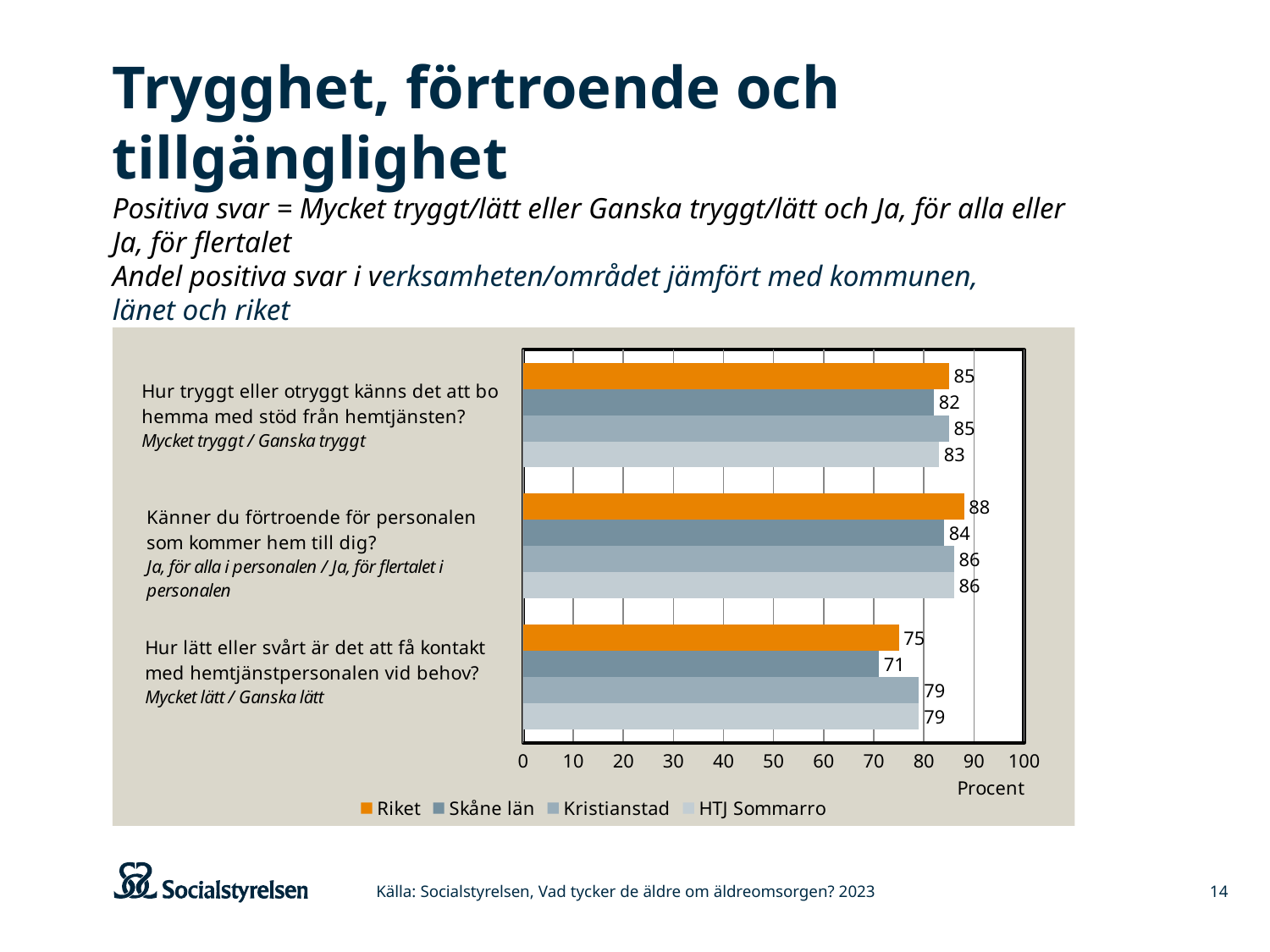
Which series has the highest value on the question "Känner du förtroende för personalen som kommer hem till dig?"? Riket What is the difference between Kristianstad and Skåne län on the question "Hur lätt eller svårt är det att få kontakt med hemtjänstpersonalen vid behov?"? 8 What is the value for Skåne län on the question "Hur lätt eller svårt är det att få kontakt med hemtjänstpersonalen vid behov?"? 71 What is the value for HTJ Sommarro on the question "Hur tryggt eller otryggt känns det att bo hemma med stöd från hemtjänsten?"? 83 What type of chart is shown on the slide? bar chart Which series has the lowest value on the question "Hur lätt eller svårt är det att få kontakt med hemtjänstpersonalen vid behov?"? Skåne län What is the value for Riket on the question "Känner du förtroende för personalen som kommer hem till dig?"? 88 What label is shown on the horizontal axis of the chart? Procent Which is larger on the question "Känner du förtroende för personalen som kommer hem till dig?": Riket or Skåne län? Riket How many question categories are plotted on the chart? 3 How many series does the legend list? 4 Is the value for Riket on the question "Hur lätt eller svårt är det att få kontakt med hemtjänstpersonalen vid behov?" greater or less than 80? less